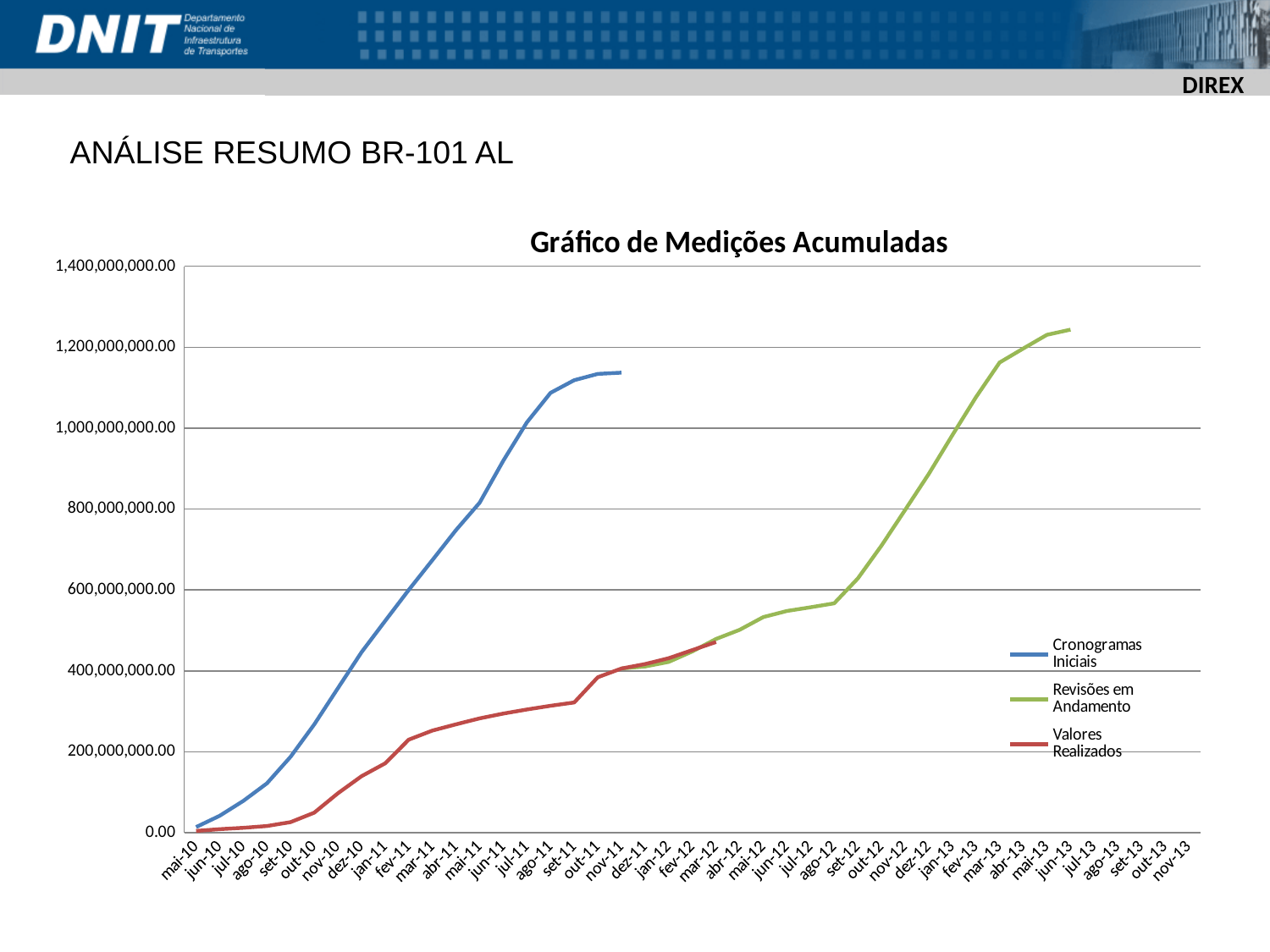
Which is larger: the final value of Revisões em Andamento or the final value of Cronogramas Iniciais? Revisões em Andamento How many series does the legend of the chart list? 3 At jan-11, which series has the larger value: Cronogramas Iniciais or Valores Realizados? Cronogramas Iniciais What kind of chart is shown on the slide? Line chart Is the value of Valores Realizados at mar-12 greater or less than 600,000,000.00? less Is the value of Valores Realizados at jan-11 greater or less than 200,000,000.00? less Is the value of Cronogramas Iniciais at nov-11 greater or less than 1,000,000,000.00? greater Which series is drawn in green in the chart? Revisões em Andamento What is the title of the chart? Gráfico de Medições Acumuladas Which series reaches the highest value on the chart? Revisões em Andamento Do the values of the Cronogramas Iniciais series rise or fall along the x axis? Rise